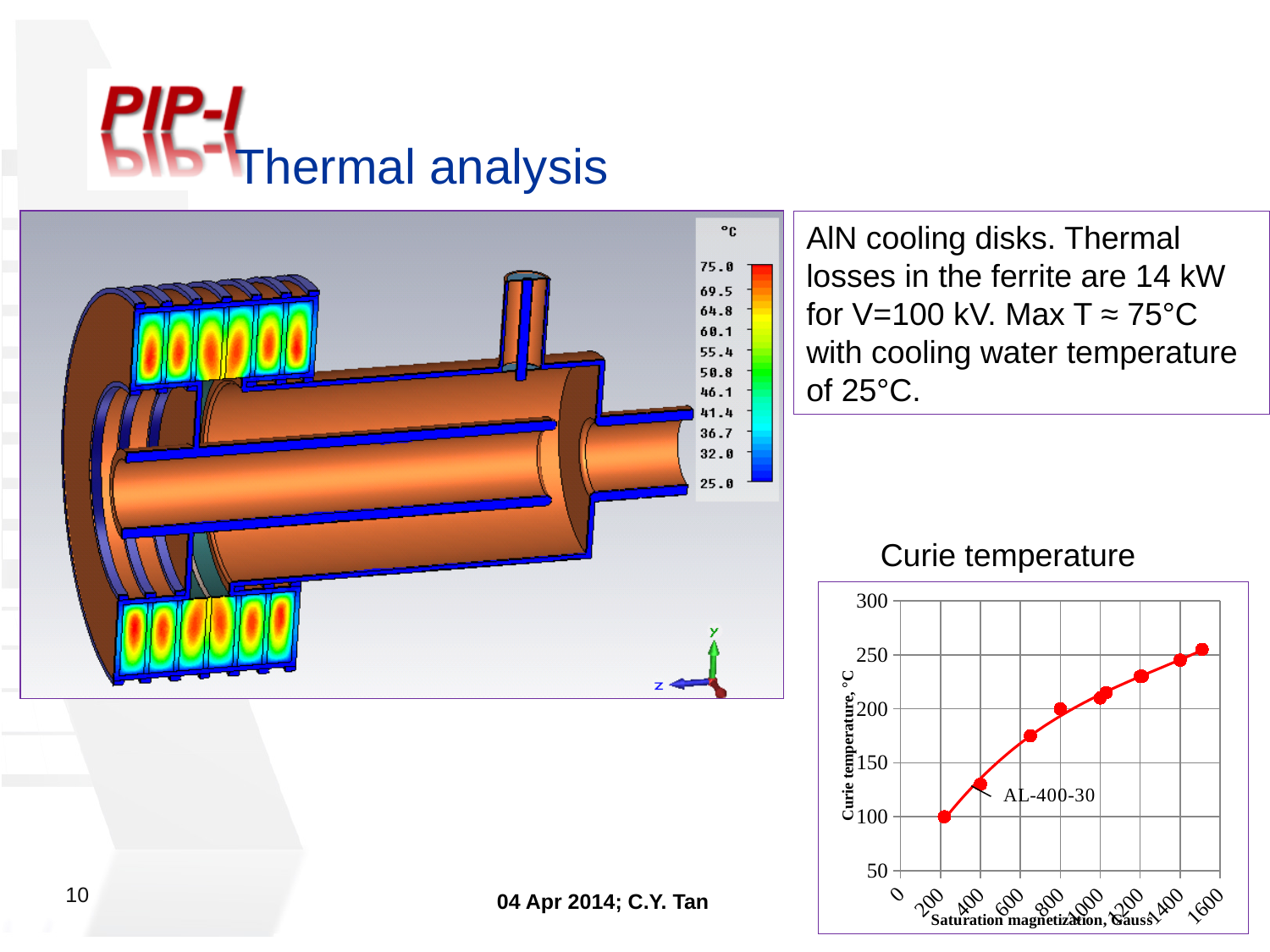
In the Curie temperature chart, does the Curie temperature rise or fall as saturation magnetization increases? rise In the Curie temperature chart, is the Curie temperature at 400 Gauss greater or less than 150? less In the Curie temperature chart, which has the higher Curie temperature: the point at 400 Gauss or the point at 1200 Gauss? 1200 Gauss In the Curie temperature chart, is the Curie temperature at 1200 Gauss greater or less than 200? greater What kind of chart is the Curie temperature chart? line chart In the Curie temperature chart, is the Curie temperature at 600 Gauss greater or less than 150? greater What material name is annotated on the curve in the Curie temperature chart? AL-400-30 What is the label of the x axis in the Curie temperature chart? Saturation magnetization, Gauss